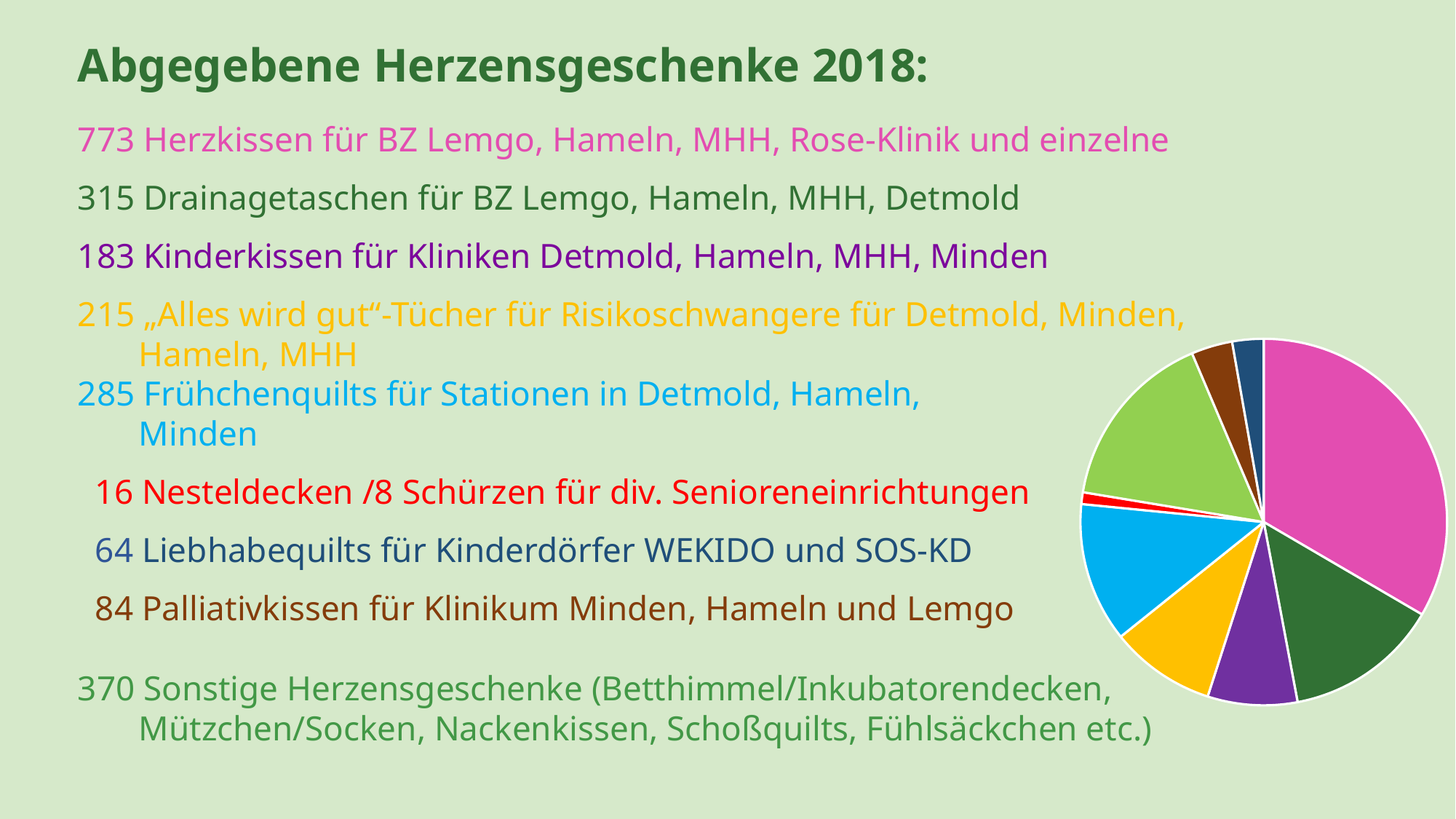
How many slices does the pie chart have? 9 How many Drainagetaschen were given out in 2018 according to the slide? 315 What colour is the largest slice of the pie chart? pink How many Palliativkissen were given out in 2018 according to the slide? 84 What kind of chart is shown on the slide? pie chart What is the difference between the number of Herzkissen and the number of Drainagetaschen? 458 How many Sonstige Herzensgeschenke were given out in 2018 according to the slide? 370 What is the title of the slide containing the pie chart? Abgegebene Herzensgeschenke 2018: Which is larger: the number of Frühchenquilts or the number of "Alles wird gut"-Tücher? Frühchenquilts How many Herzkissen were given out in 2018 according to the slide? 773 Which category has the smallest slice in the pie chart? Nesteldecken / Schürzen Which category has the largest slice in the pie chart? Herzkissen